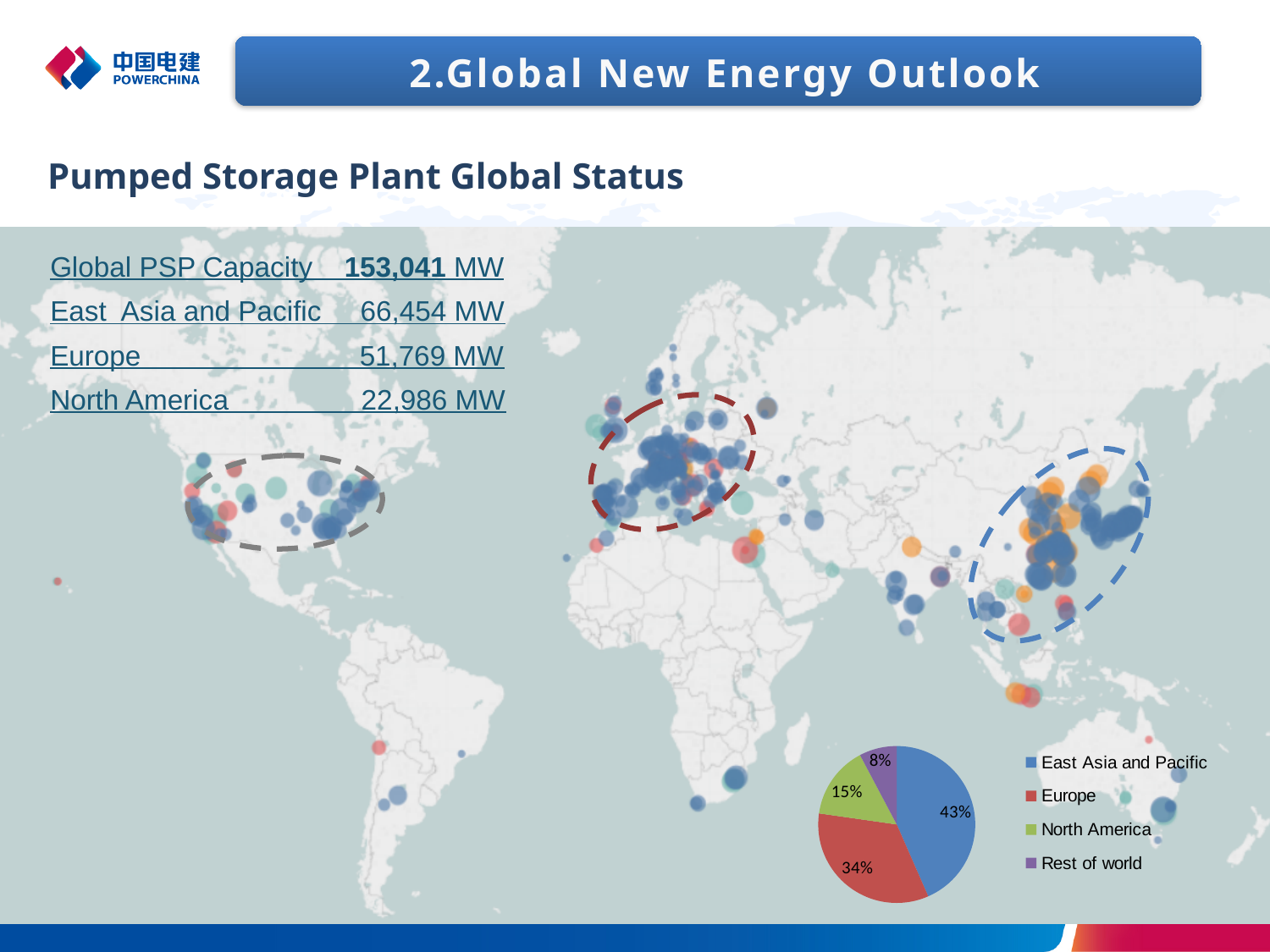
In the pie chart, what share does North America have? 15% In the pie chart, which is larger: Europe or North America? Europe In the pie chart, what share does East Asia and Pacific have? 43% What colour is the Europe slice in the pie chart? red In the pie chart, what share does Rest of world have? 8% How many entries does the pie chart legend list? 4 Which slice of the pie chart is the smallest? Rest of world How many slices does the pie chart have? 4 In the pie chart, what is the difference in percentage points between East Asia and Pacific and Europe? 9 Which slice of the pie chart is the largest? East Asia and Pacific What kind of chart is shown in the lower right of the slide? pie chart